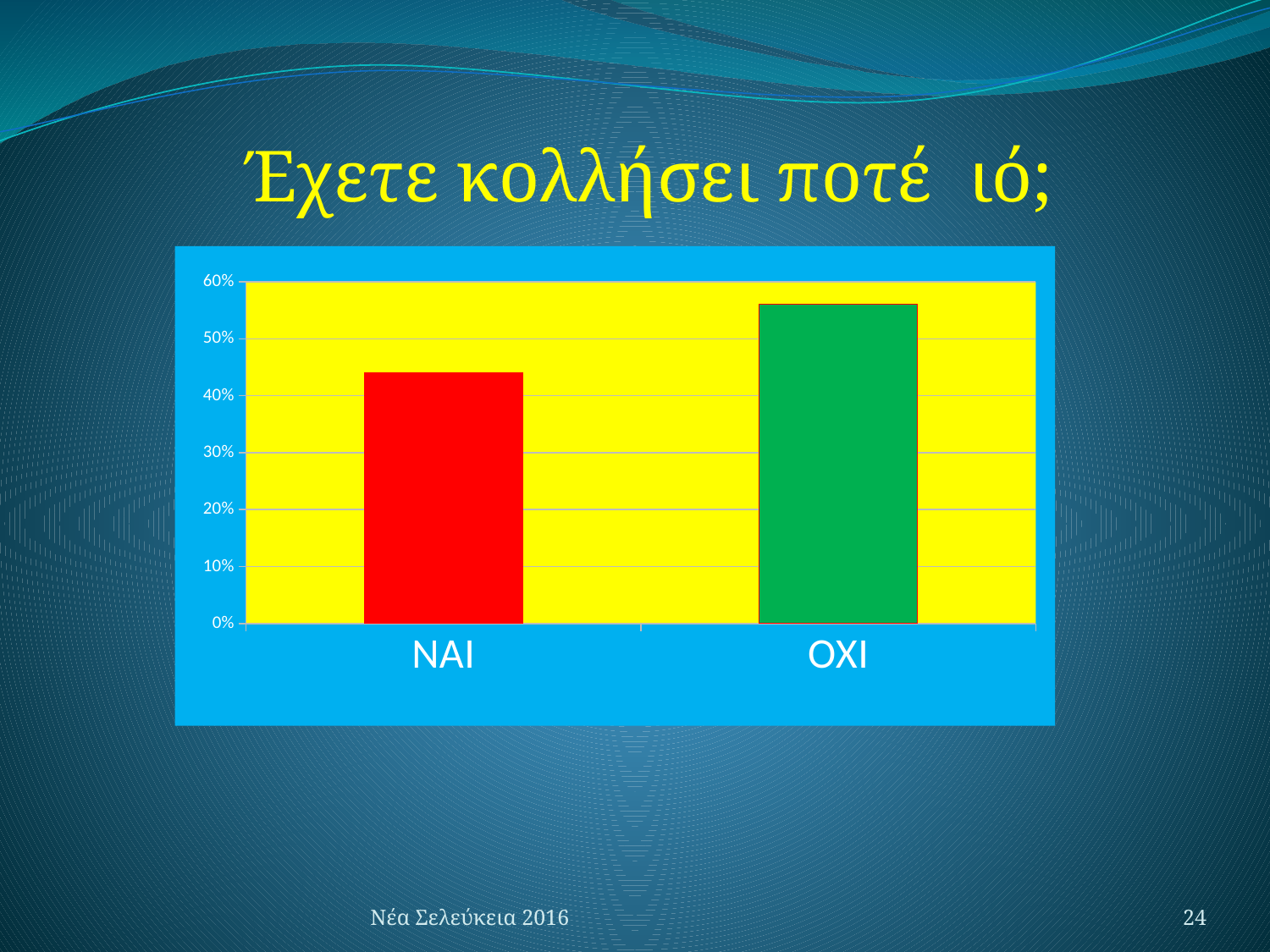
Which category has the highest bar in the chart? OXI What is the highest value shown on the y axis of the chart? 60% Which is larger, the value for NAI or the value for OXI? OXI How many categories are shown on the x axis of the chart? 2 Is the value for OXI greater or less than 60%? less Is the value for NAI greater or less than 40%? greater Is the value for OXI greater or less than 50%? greater What kind of chart is shown on the slide? bar chart What colour is the bar for NAI? red Which category has the lowest bar in the chart? NAI